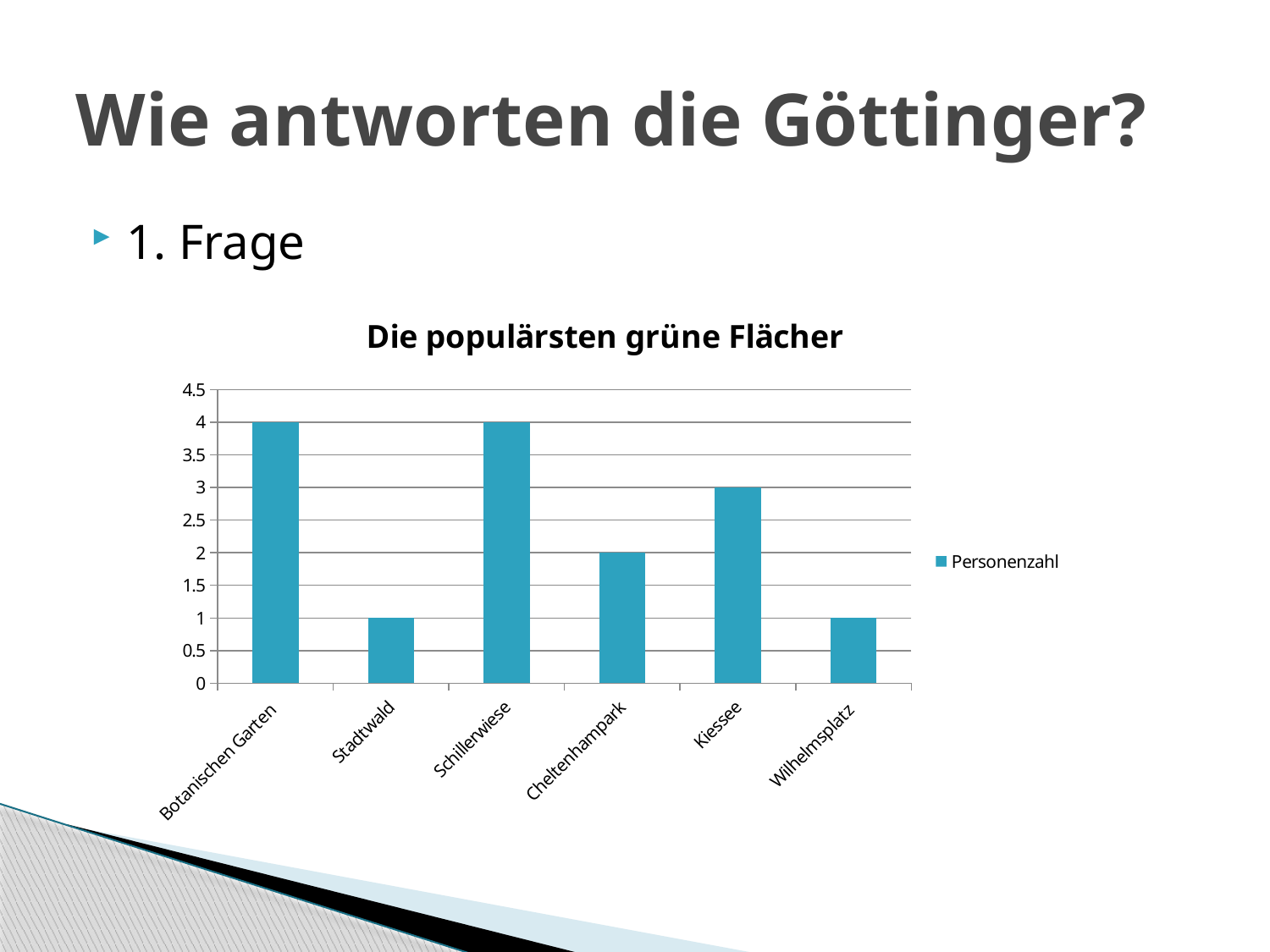
Which has a larger value, Kiessee or Cheltenhampark? Kiessee Is the value for Kiessee greater or less than 2? greater What is the value for Kiessee? 3 What is the name of the series shown in the legend? Personenzahl What is the difference between the values for Schillerwiese and Wilhelmsplatz? 3 How many categories are shown on the x axis? 6 What is the value for Cheltenhampark? 2 What is the value for Botanischen Garten? 4 What is the value for Stadtwald? 1 What is the title of the chart? Die populärsten grüne Flächer What type of chart is shown on the slide? bar chart How many series does the legend list? 1